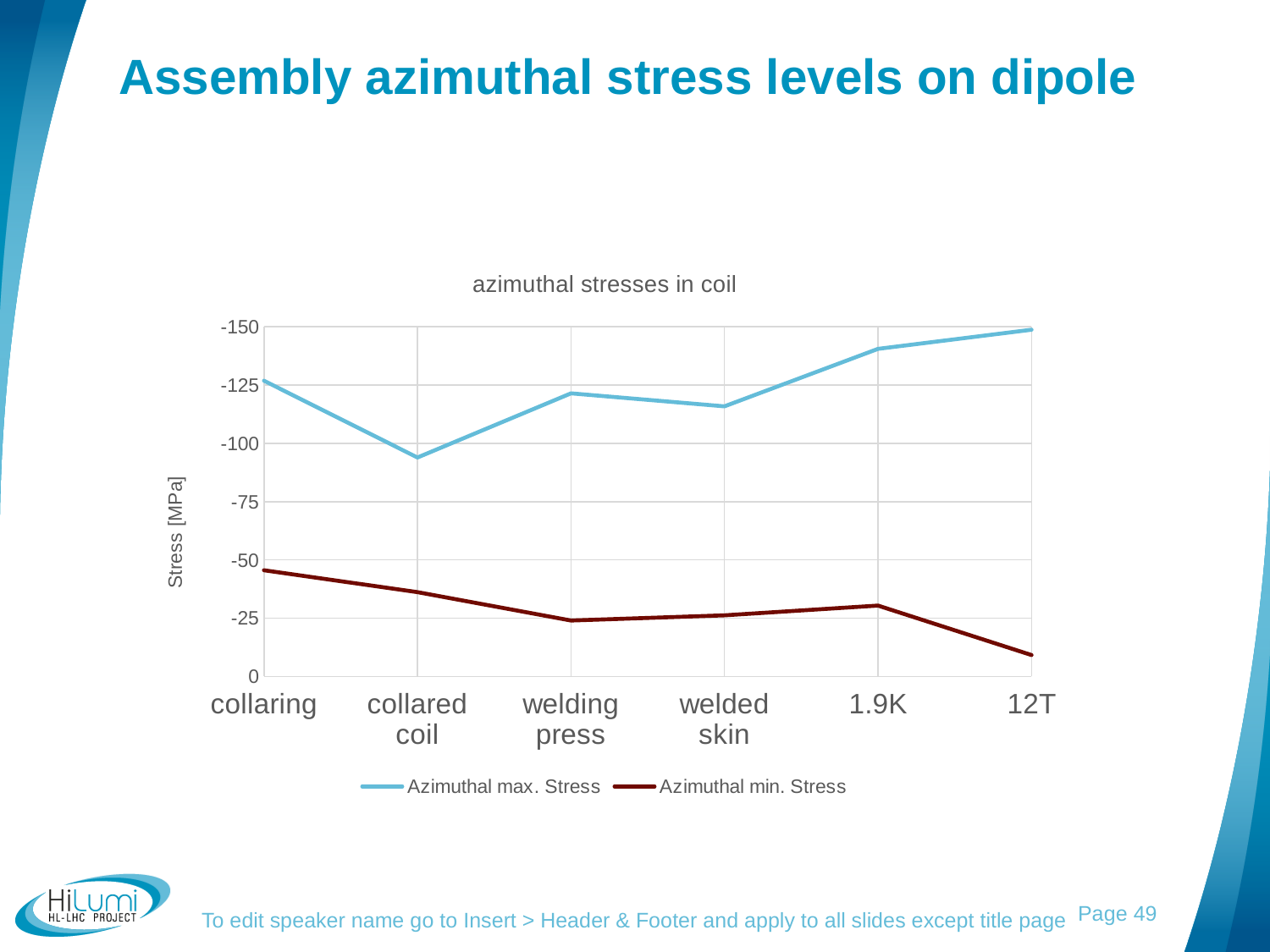
For the Azimuthal max. Stress series, at which category is the stress furthest from zero (most negative)? 12T How many series does the chart legend list? 2 What kind of chart is shown on the slide? line chart At collaring, which series has the more negative stress value, Azimuthal max. Stress or Azimuthal min. Stress? Azimuthal max. Stress What is the label of the vertical axis of the chart? Stress [MPa] For the Azimuthal max. Stress series, at which category is the stress closest to zero? collared coil For the Azimuthal min. Stress series, at which category is the stress furthest from zero (most negative)? collaring Is the Azimuthal max. Stress value at collared coil greater or less than -100? greater Is the Azimuthal min. Stress value at 12T greater or less than -25? greater What is the title of the chart? azimuthal stresses in coil For the Azimuthal min. Stress series, at which category is the stress closest to zero? 12T How many categories are shown along the x axis of the chart? 6